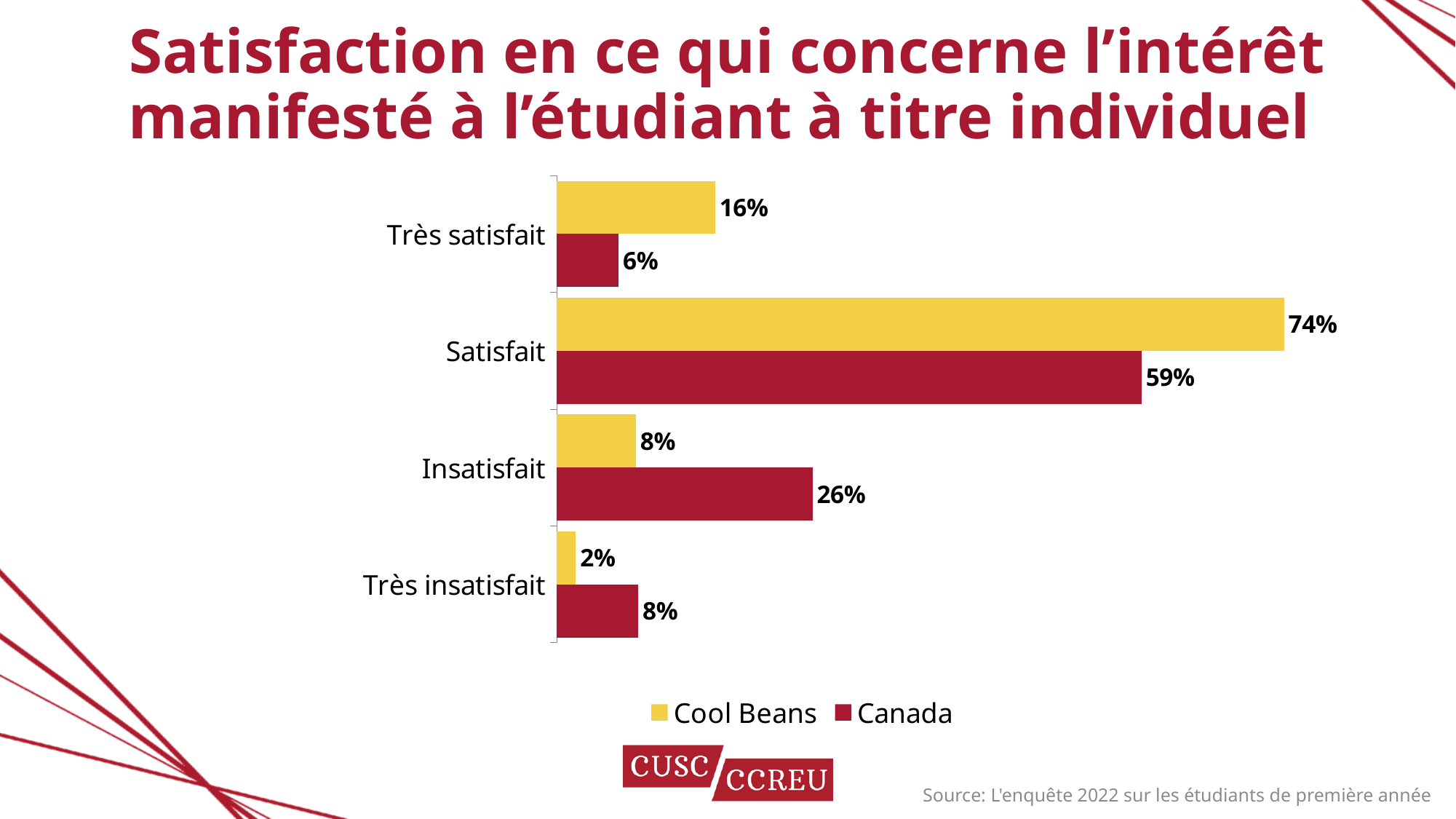
What is the difference between the Cool Beans and Canada values for Satisfait? 15% What is the Cool Beans value for Satisfait? 74% Which category has the highest Canada value? Satisfait How many categories are shown on the chart? 4 How many series does the legend list? 2 What is the Canada value for Insatisfait? 26% What is the difference between the Canada and Cool Beans values for Insatisfait? 18% What is the Canada value for Très satisfait? 6% What kind of chart is shown on the slide? Bar chart What is the Cool Beans value for Très insatisfait? 2% For Très satisfait, which series has the larger value, Cool Beans or Canada? Cool Beans Which category has the lowest Cool Beans value? Très insatisfait